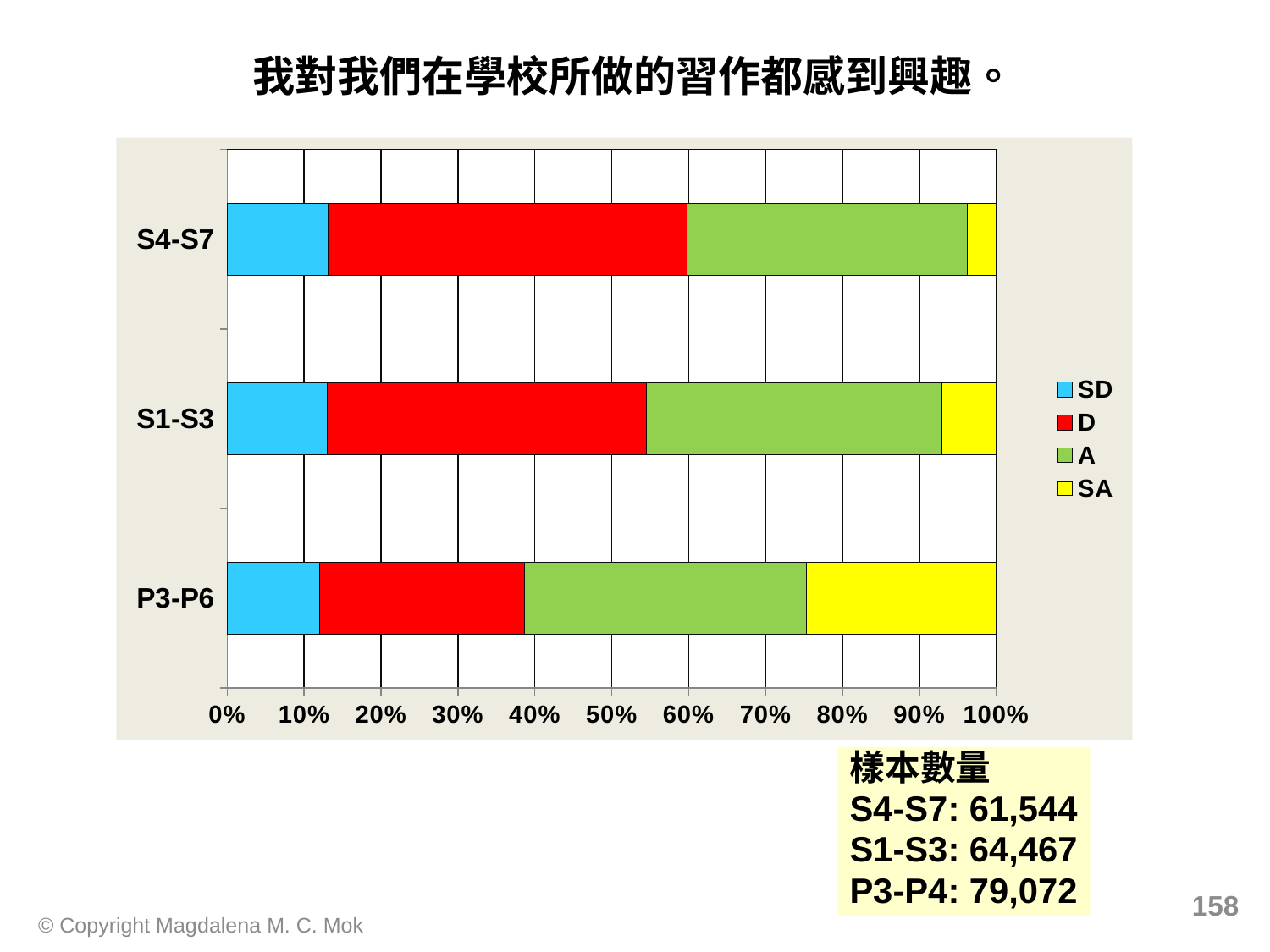
What kind of chart is shown on the slide? Stacked bar chart Which group has the largest SA share? P3-P6 Which group has the smallest SA share? S4-S7 Which colour represents the SA series in the chart? Yellow What are the legend entries of the chart, in order? SD, D, A, SA How many categories (student groups) are plotted on the chart? 3 Which is larger: the D share for S4-S7 or the D share for P3-P6? S4-S7 Is the SD share for P3-P6 greater or less than 20%? less Is the SA share for S4-S7 greater or less than 10%? less Is the SA share for P3-P6 greater or less than 20%? greater How many series does the legend list? 4